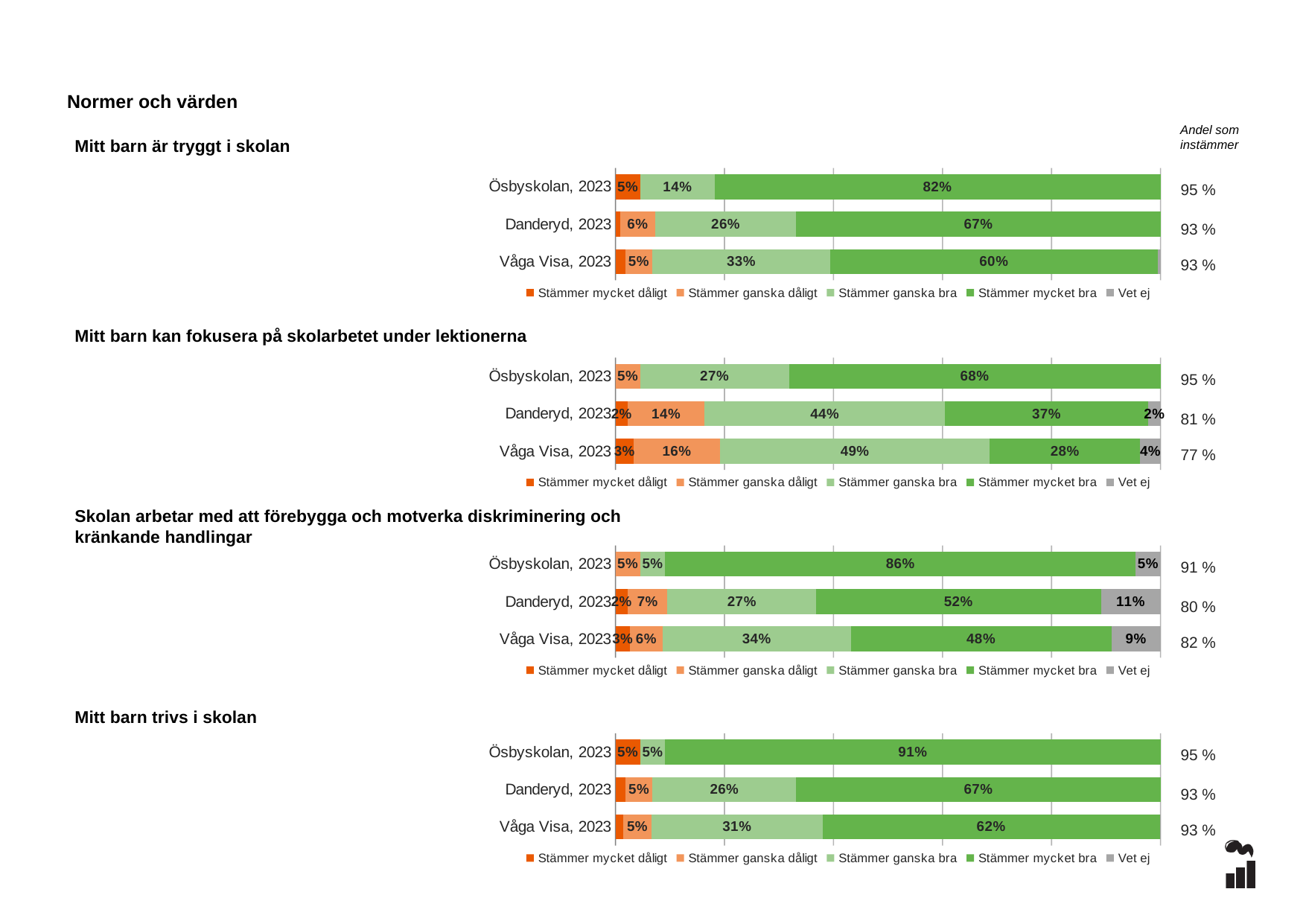
In the chart 'Skolan arbetar med att förebygga och motverka diskriminering och kränkande handlingar', what is the 'Vet ej' value for Danderyd, 2023? 11% In the chart 'Mitt barn är tryggt i skolan', what is the 'Stämmer mycket bra' value for Ösbyskolan, 2023? 82% In the chart 'Mitt barn trivs i skolan', what is the 'Stämmer mycket bra' value for Ösbyskolan, 2023? 91% In the chart 'Mitt barn är tryggt i skolan', what is the 'Stämmer ganska bra' value for Våga Visa, 2023? 33% In the chart 'Mitt barn kan fokusera på skolarbetet under lektionerna', what is the 'Vet ej' value for Våga Visa, 2023? 4% In the chart 'Mitt barn trivs i skolan', what is the difference between the 'Stämmer mycket bra' values for Danderyd, 2023 and Våga Visa, 2023? 5% In the chart 'Skolan arbetar med att förebygga och motverka diskriminering och kränkande handlingar', which is larger: the 'Stämmer mycket bra' value for Danderyd, 2023 or for Våga Visa, 2023? Danderyd, 2023 How many rows (categories) does the chart 'Mitt barn trivs i skolan' show? 3 What kind of chart is used for 'Mitt barn kan fokusera på skolarbetet under lektionerna'? Stacked bar chart In the chart 'Mitt barn kan fokusera på skolarbetet under lektionerna', what is the difference between the 'Stämmer ganska bra' values for Våga Visa, 2023 and Danderyd, 2023? 5% In the chart 'Mitt barn kan fokusera på skolarbetet under lektionerna', which row has the highest 'Stämmer mycket bra' value? Ösbyskolan, 2023 How many series does the legend of the chart 'Mitt barn är tryggt i skolan' list? 5